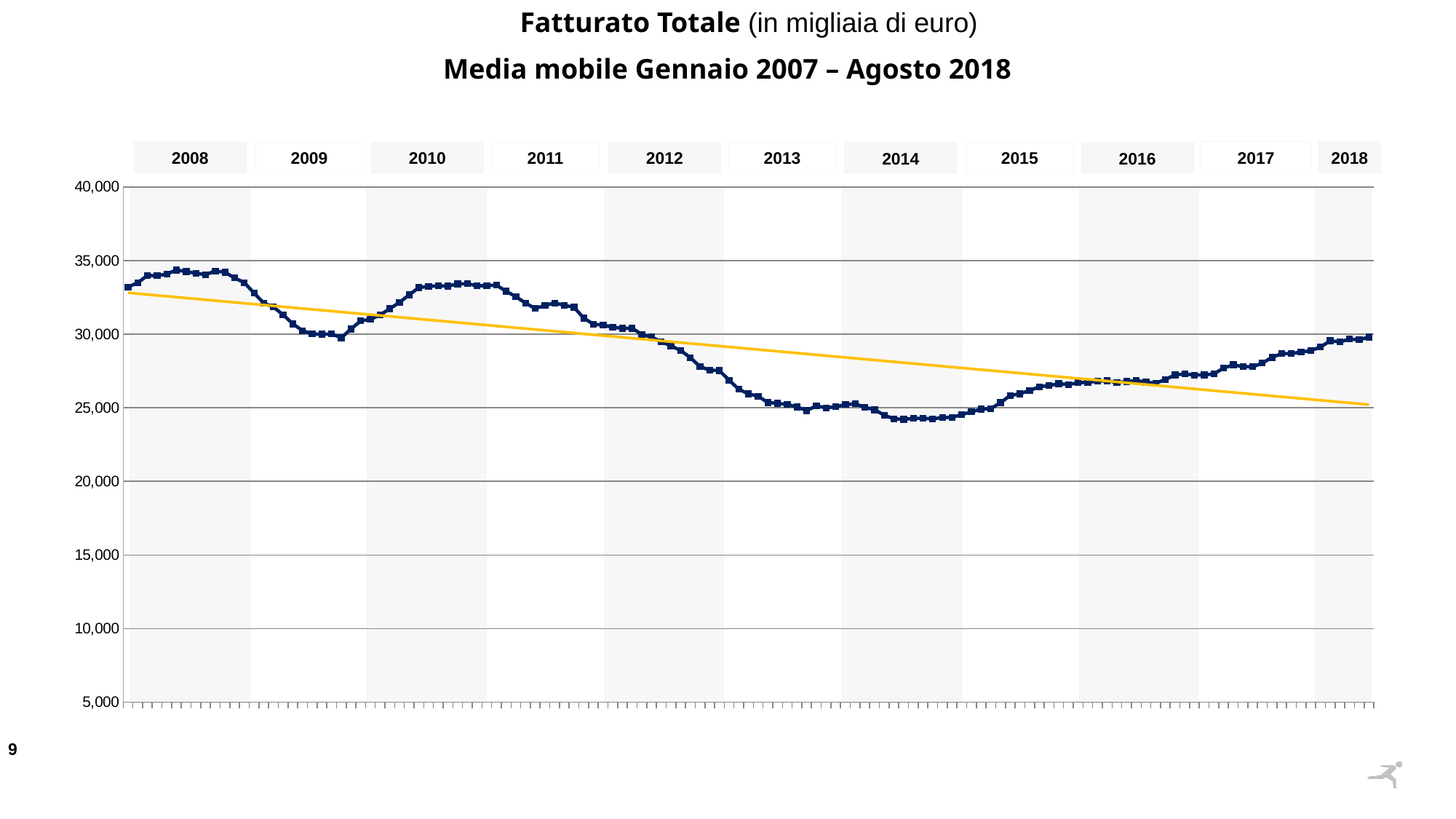
In which year does the moving average reach its lowest level? 2014 What kind of chart is shown on the slide? line chart Does the yellow trend line rise or fall from left to right? fall What is the highest value shown on the vertical axis? 40,000 Which is larger, the moving average in mid-2010 or in mid-2014? mid-2010 In which year does the moving average reach its highest level? 2008 Is the value of the moving average in the middle of 2013 greater or less than 30,000? less What is the title of the chart? Fatturato Totale (in migliaia di euro) Media mobile Gennaio 2007 – Agosto 2018 Is the value of the moving average at the start of 2008 greater or less than 30,000? greater Is the value of the moving average in the middle of 2014 greater or less than 25,000? less How many year labels are shown along the top of the chart? 11